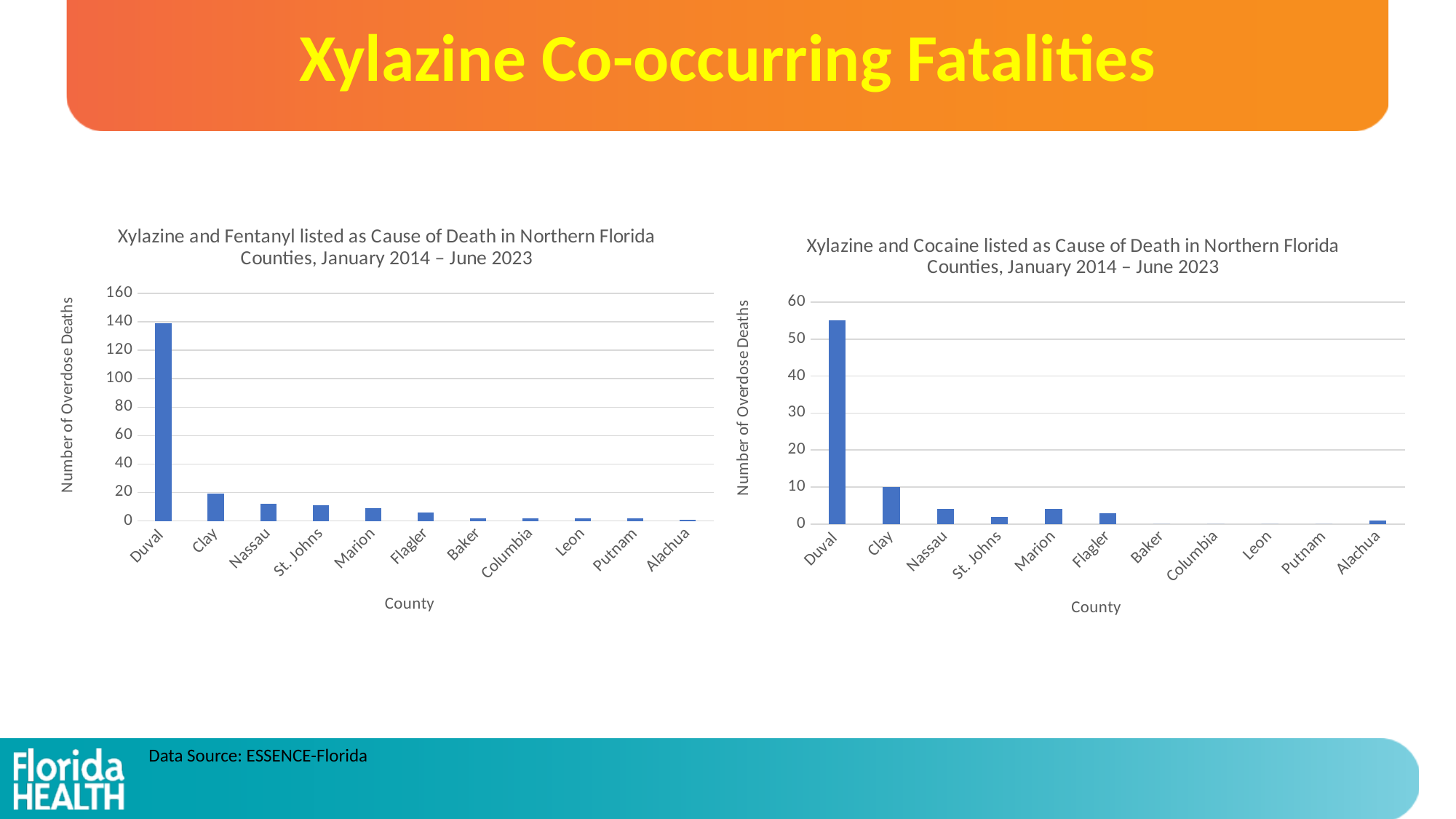
In the right chart (Xylazine and Cocaine), is the value for Duval greater or less than 50? greater In the left chart (Xylazine and Fentanyl), do the values generally rise or fall moving from Duval to Alachua along the x axis? Fall What kind of chart is the left chart, 'Xylazine and Fentanyl listed as Cause of Death in Northern Florida Counties'? Bar chart In the left chart (Xylazine and Fentanyl), is the value for Clay greater or less than 40? less In the left chart (Xylazine and Fentanyl), which county has more overdose deaths, Clay or Nassau? Clay What is the y-axis label on the right chart (Xylazine and Cocaine)? Number of Overdose Deaths In the left chart (Xylazine and Fentanyl), which county has the highest number of overdose deaths? Duval In the right chart (Xylazine and Cocaine), how many counties are listed on the x axis? 11 In the right chart (Xylazine and Cocaine), which county has the highest number of overdose deaths? Duval In the left chart (Xylazine and Fentanyl), how many counties are shown on the x axis? 11 In the right chart (Xylazine and Cocaine), which county has more overdose deaths, Nassau or St. Johns? Nassau In the left chart (Xylazine and Fentanyl), is the value for Duval greater or less than 120? greater